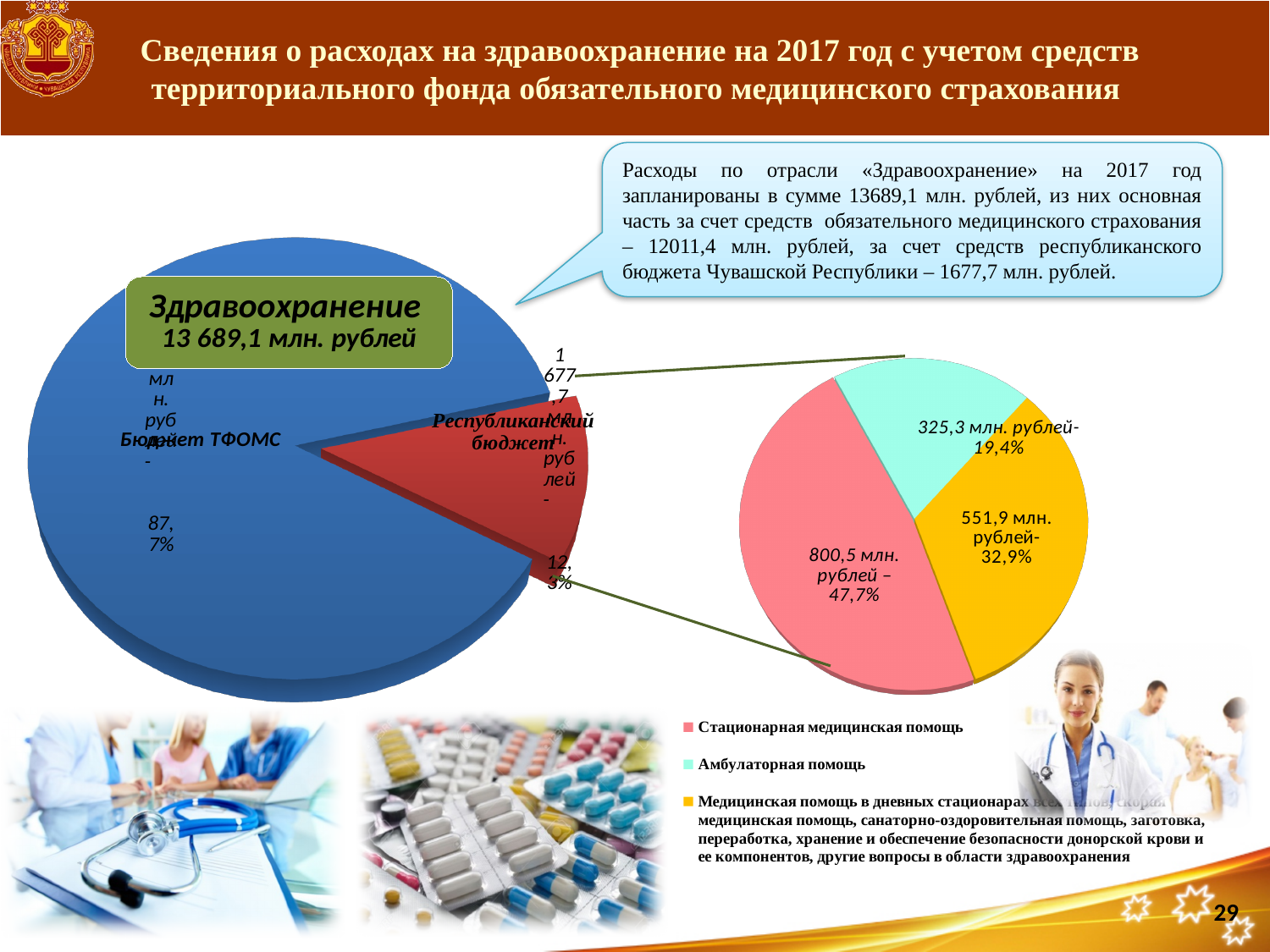
On the left pie chart, what total amount is shown for Здравоохранение? 13 689,1 млн. рублей What kind of chart is the left chart on the slide? Pie chart On the right pie chart, which category has the smallest share? Амбулаторная помощь On the right pie chart, what share is shown for Стационарная медицинская помощь? 47,7% On the left pie chart, what share is shown for Бюджет ТФОМС? 87,7% On the right pie chart, what value in млн. рублей is shown for Амбулаторная помощь? 325,3 млн. рублей On the right pie chart, what is the difference in percentage points between the share for Стационарная медицинская помощь (47,7%) and Амбулаторная помощь (19,4%)? 28,3 On the right pie chart, what share is shown for the yellow slice (Медицинская помощь в дневных стационарах...)? 32,9% On the right pie chart, which category has the largest share? Стационарная медицинская помощь On the right pie chart, how many slices are there? 3 On the right pie chart, which is larger: the share for Стационарная медицинская помощь or the share for Амбулаторная помощь? Стационарная медицинская помощь On the right pie chart, how many entries does the legend list? 3